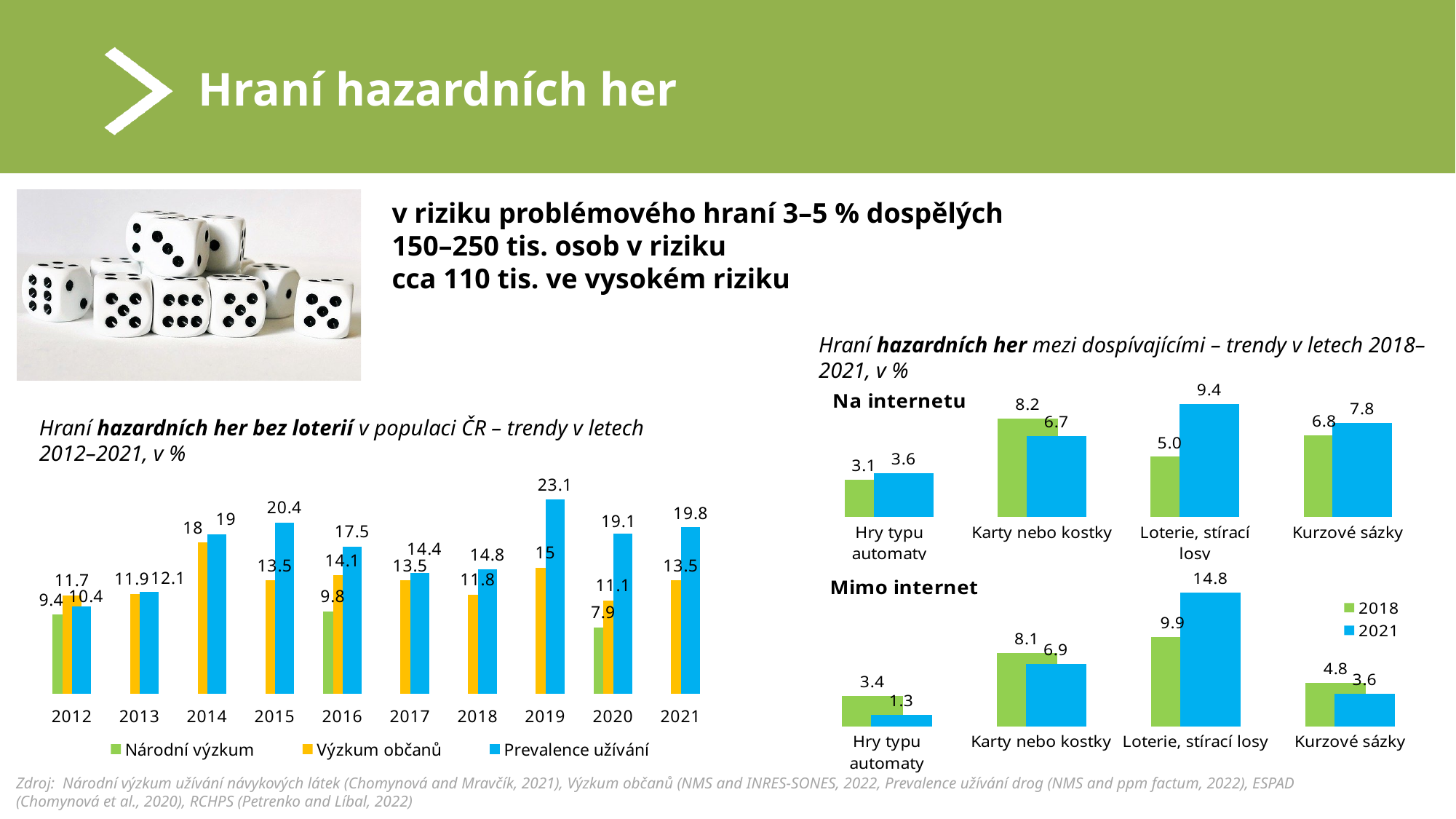
What type of chart is 'Hraní hazardních her bez loterií v populaci ČR'? bar chart In the chart 'Hraní hazardních her bez loterií v populaci ČR', which year has the highest Prevalence užívání value? 2019 In the chart 'Hraní hazardních her bez loterií v populaci ČR', how many years are shown on the x axis? 10 In the 'Mimo internet' chart, what is the 2021 value for Hry typu automaty? 1.3 In the chart 'Hraní hazardních her bez loterií v populaci ČR', what is the value of Prevalence užívání in 2019? 23.1 In the 'Mimo internet' chart, what is the difference between the 2021 and 2018 values for Loterie, stírací losy? 4.9 In the chart 'Hraní hazardních her bez loterií v populaci ČR', how many series does the legend list? 3 In the chart 'Hraní hazardních her bez loterií v populaci ČR', what is the difference between Prevalence užívání and Výzkum občanů in 2020? 8 In the 'Na internetu' chart, which category has the lowest 2018 value? Hry typu automaty In the 'Mimo internet' chart, which is larger for Karty nebo kostky: the 2018 value or the 2021 value? 2018 In the 'Na internetu' chart, what is the 2021 value for Loterie, stírací losy? 9.4 In the chart 'Hraní hazardních her bez loterií v populaci ČR', what is the value of Výzkum občanů in 2014? 18